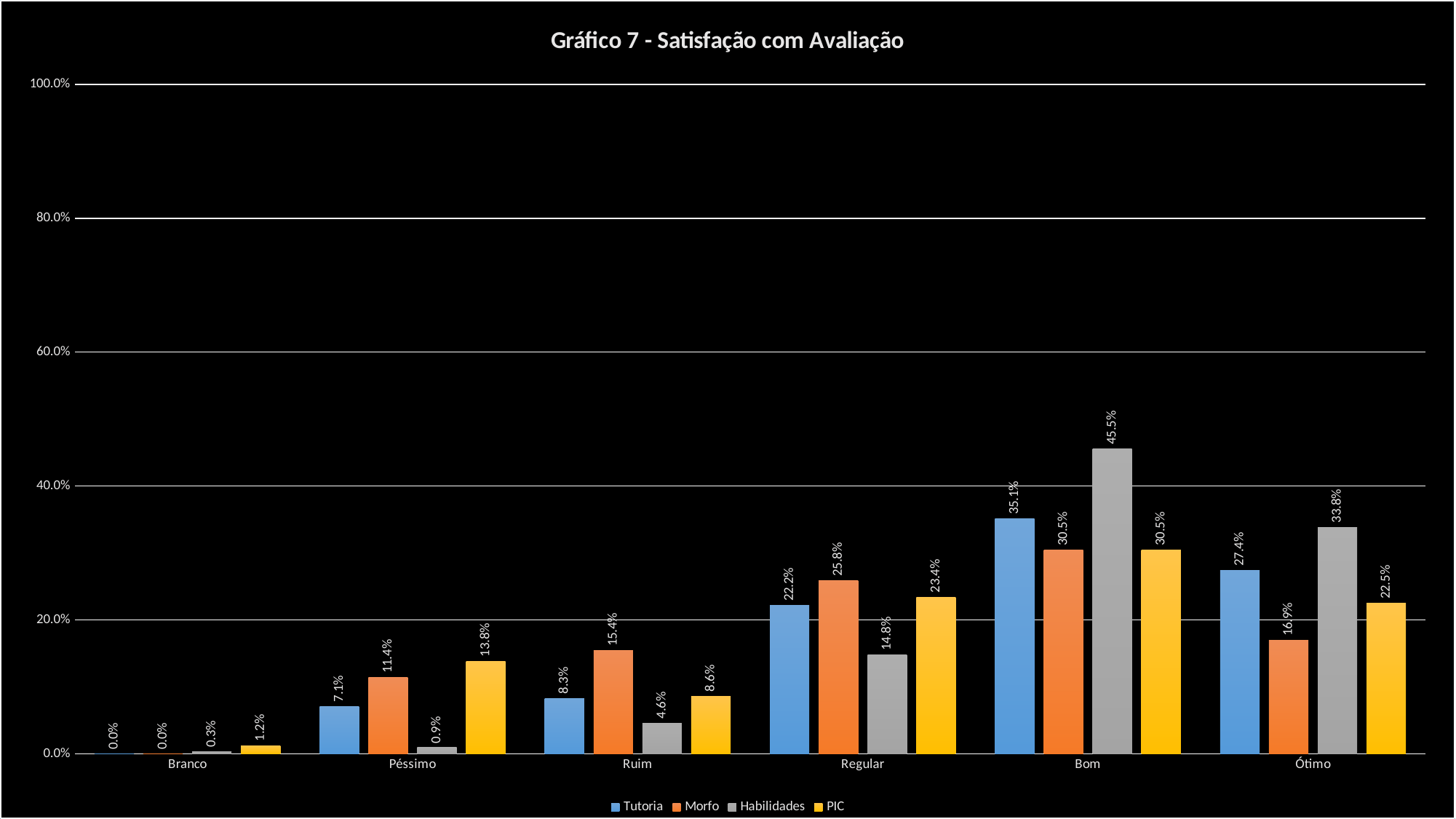
What is the value for Habilidades in the Bom category? 45.5% What is the difference between Habilidades and Tutoria in the Bom category? 10.4% Which category has the highest value for Morfo? Bom What is the value for Tutoria in the Regular category? 22.2% Is the value for Habilidades in the Ótimo category greater or less than 40.0%? less Which series has the lowest value in the Ótimo category? Morfo How many categories are shown on the x axis? 6 What is the title of the chart? Gráfico 7 - Satisfação com Avaliação What kind of chart is shown on the slide? bar chart How many series does the legend list? 4 Which is larger in the Ruim category, Morfo or PIC? Morfo What is the value for PIC in the Péssimo category? 13.8%